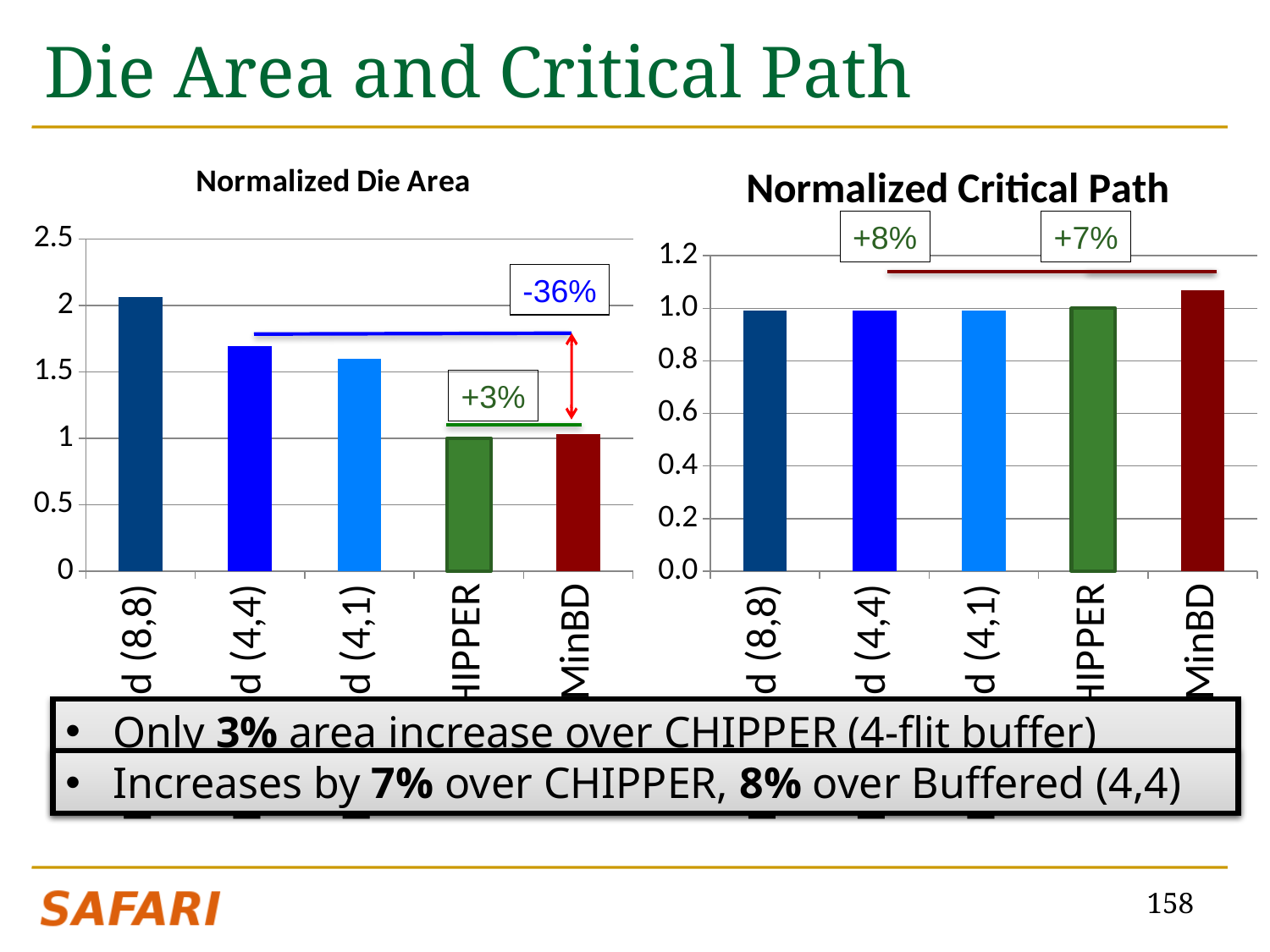
In the Normalized Die Area chart, which category has the highest bar? Buffered (8,8) In the Normalized Critical Path chart, is the value for CHIPPER greater or less than 0.8? greater In the Normalized Critical Path chart, is the value for MinBD greater or less than 1.2? less In the Normalized Die Area chart, is the value for the (8,8) bar greater or less than 2? greater What is the title of the chart on the right side of the slide? Normalized Critical Path In the Normalized Critical Path chart, which category has the highest bar? MinBD In the Normalized Die Area chart, which is larger, the (8,8) bar or the MinBD bar? (8,8) How many bars are plotted in the Normalized Die Area chart? 5 How many bars are plotted in the Normalized Critical Path chart? 5 What percentage annotation is shown above the MinBD bar in the Normalized Die Area chart? +3% What type of chart is the Normalized Die Area chart? bar chart